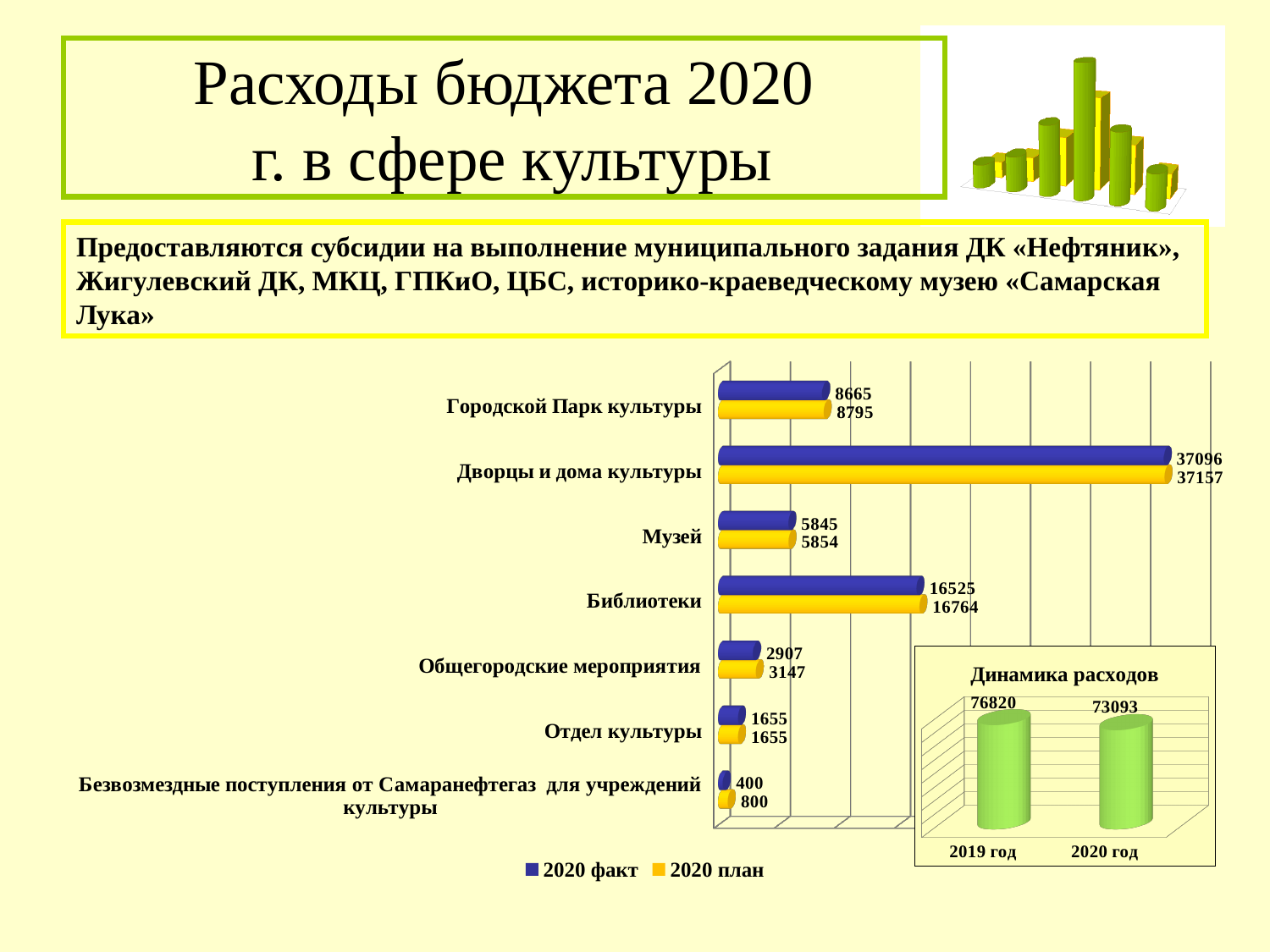
How many series does the legend of the large horizontal bar chart list? 2 What kind of chart is the large chart on the left of the slide? Bar chart In the chart titled Динамика расходов, what is the value for 2019 год? 76820 In the large horizontal bar chart, which is larger for Городской Парк культуры: the 2020 факт value or the 2020 план value? 2020 план How many categories are shown in the large horizontal bar chart? 7 In the large horizontal bar chart, what is the difference between the 2020 план and 2020 факт values for Библиотеки? 239 In the large horizontal bar chart, which category has the lowest 2020 план value? Безвозмездные поступления от Самаранефтегаз для учреждений культуры In the large horizontal bar chart, what is the 2020 факт value for Библиотеки? 16525 In the large horizontal bar chart, which category has the highest 2020 факт value? Дворцы и дома культуры In the chart titled Динамика расходов, what is the difference between the 2019 год and 2020 год values? 3727 In the large horizontal bar chart, what is the 2020 план value for Общегородские мероприятия? 3147 In the large horizontal bar chart, what is the 2020 план value for Дворцы и дома культуры? 37157